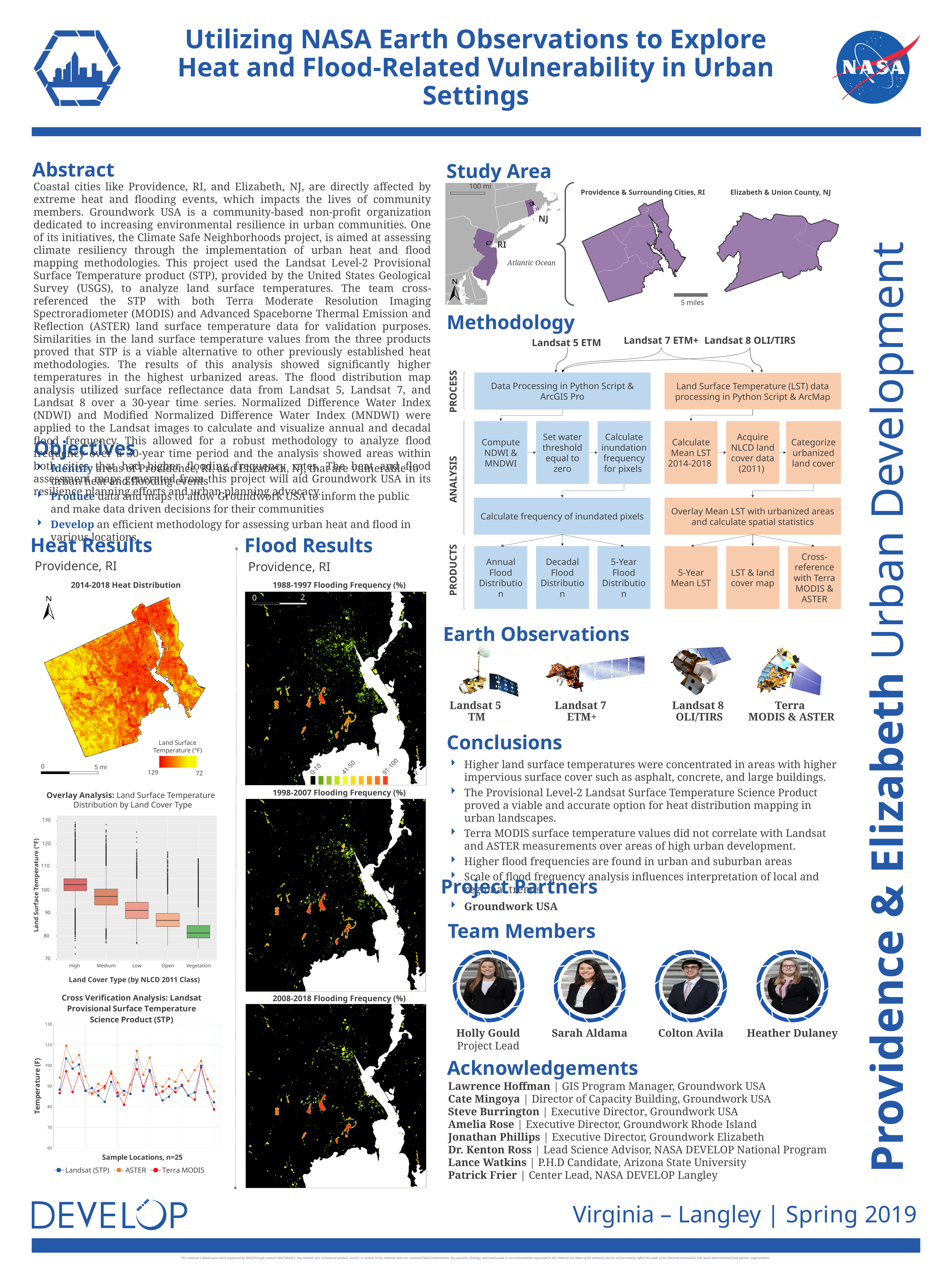
Which series are listed in the legend of the 'Cross Verification Analysis' chart? Landsat (STP), ASTER, Terra MODIS In the 'Overlay Analysis' chart, is the median land surface temperature for the High land cover type greater or less than 100? greater In the 'Overlay Analysis' chart, which has a higher median land surface temperature, Medium or Open? Medium How many series does the legend of the 'Cross Verification Analysis' chart list? 3 In the 'Overlay Analysis: Land Surface Temperature Distribution by Land Cover Type' chart, how many land cover type categories are shown on the x axis? 5 In the 'Overlay Analysis' chart, is the median land surface temperature for Vegetation greater or less than 90? less In the 'Overlay Analysis' chart, which land cover type has the highest median land surface temperature? High According to the x-axis label of the 'Cross Verification Analysis' chart, how many sample locations are plotted? 25 What kind of chart is the 'Cross Verification Analysis: Landsat Provisional Surface Temperature Science Product (STP)' chart? line chart What is the y-axis label of the 'Overlay Analysis' chart? Land Surface Temperature (°F) In the 'Overlay Analysis' chart, do the median land surface temperatures rise or fall moving from High to Vegetation along the x axis? fall In the 'Overlay Analysis' chart, which land cover type has the lowest median land surface temperature? Vegetation